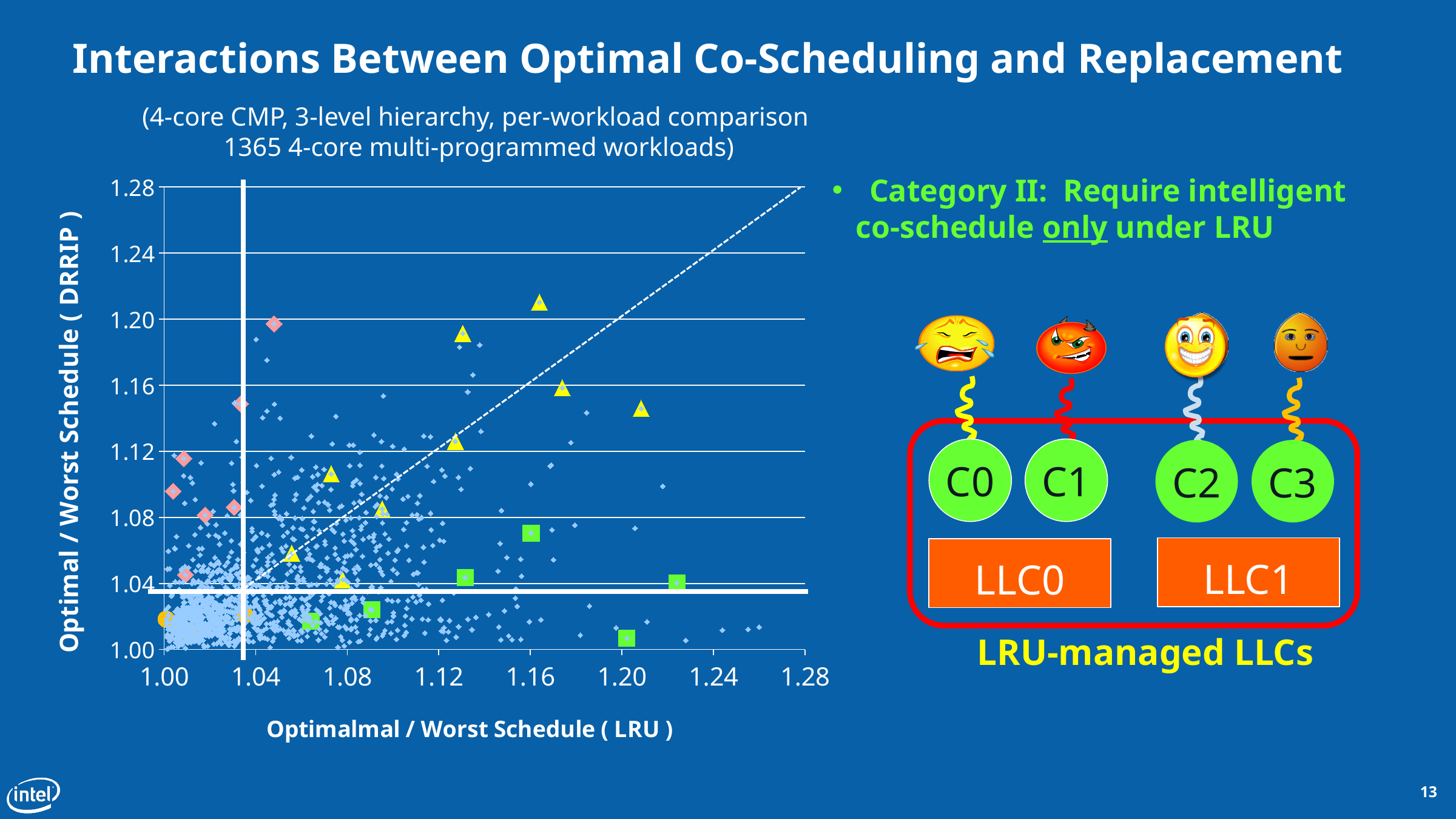
Is the y value (DRRIP) of the highest pink diamond greater or less than 1.16? greater According to the chart subtitle, how many 4-core multi-programmed workloads are compared? 1365 Is the y value (DRRIP) of the green square plotted farthest to the right greater or less than 1.08? less What is the lowest value labelled on the x axis of the scatter plot? 1.00 Is the x value (LRU) of the highest yellow triangle greater or less than 1.12? greater What is the title of the x axis of the scatter plot? Optimalmal / Worst Schedule ( LRU ) What is the title of the y axis of the scatter plot? Optimal / Worst Schedule ( DRRIP ) How many tick labels are shown along the x axis of the scatter plot? 8 What is the highest value labelled on the y axis of the scatter plot? 1.28 What kind of chart is shown on the slide? scatter plot